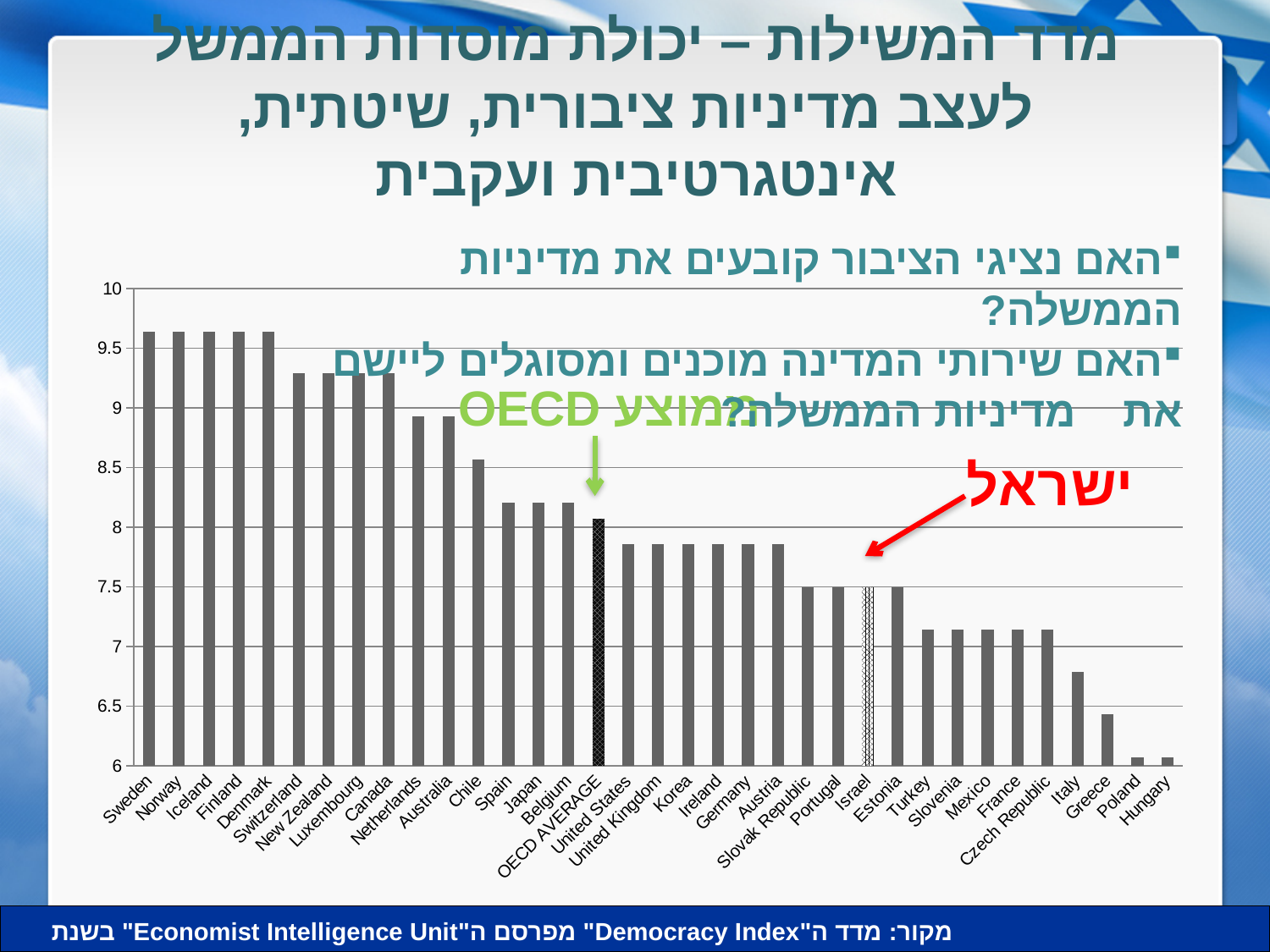
Is the value for Spain greater or less than 8? greater How many categories (bars) are plotted on the chart? 35 Which bar on the chart is pointed to by the green arrow? OECD AVERAGE Is the value for Greece greater or less than 6.5? less Which is larger, the value for OECD AVERAGE or the value for Israel? OECD AVERAGE Is the value for Israel greater or less than 8? less Do the values generally rise or fall moving from left to right along the x axis? fall Which is larger, the value for Sweden or the value for Hungary? Sweden What kind of chart is shown on the slide? bar chart